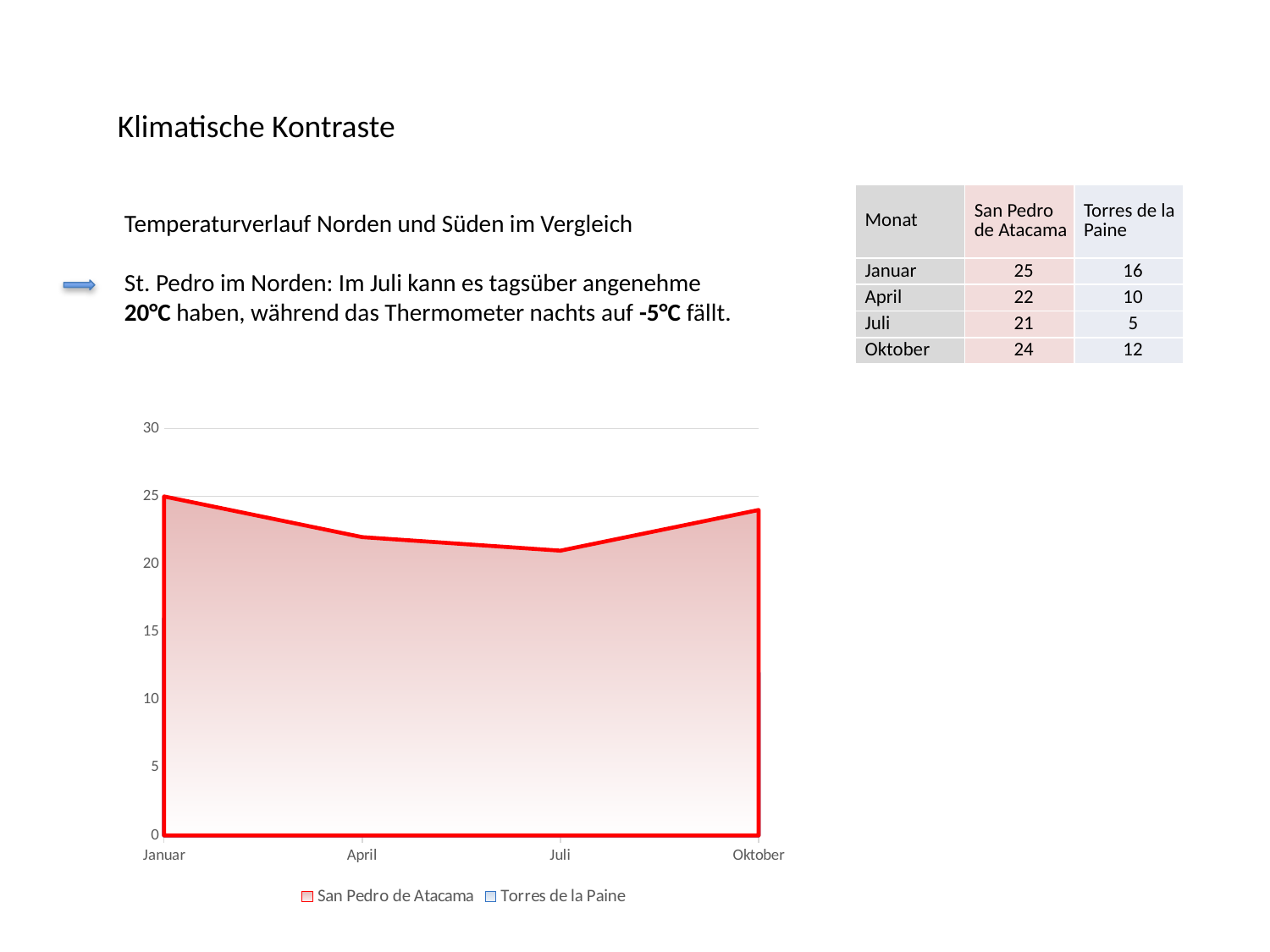
What kind of chart is shown on the slide? area chart What is the difference between the San Pedro de Atacama values for Januar and Oktober? 1 Does the San Pedro de Atacama series rise or fall from Januar to Juli? fall In which month is the San Pedro de Atacama value lowest? Juli In which month is the San Pedro de Atacama value highest? Januar What is the value for San Pedro de Atacama in Januar? 25 What is the value for San Pedro de Atacama in Juli? 21 How many months are shown on the x axis of the chart? 4 How many series does the chart legend list? 2 Is the value for San Pedro de Atacama in Juli greater or less than 25? less Is the value for San Pedro de Atacama in April greater or less than 20? greater Which series is drawn in red in the chart? San Pedro de Atacama